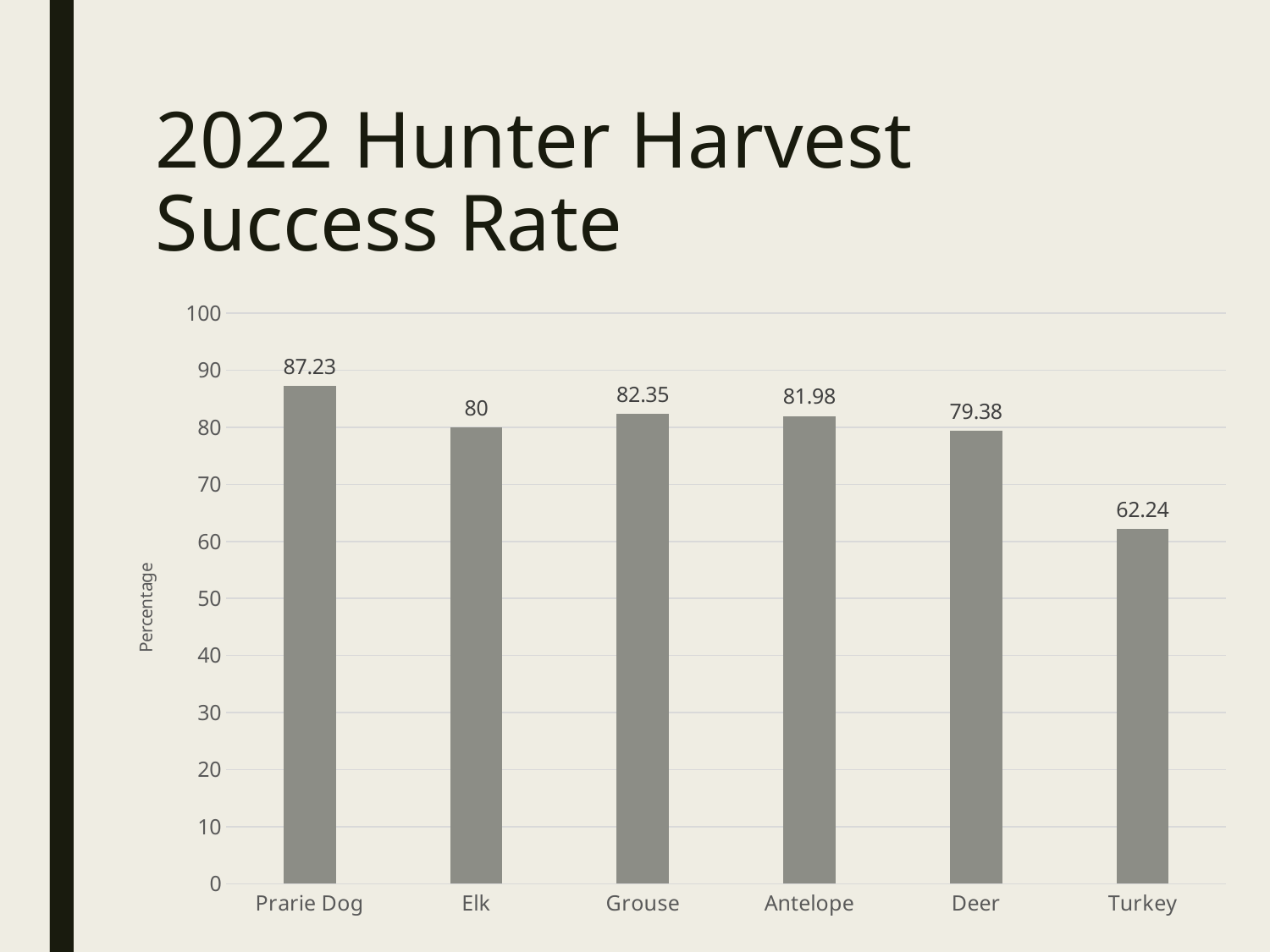
What is the value shown for Deer? 79.38 What is the difference between the values for Prarie Dog and Turkey? 24.99 What kind of chart is shown on the slide? bar chart Which category has the lowest success rate? Turkey Is the value for Antelope greater or less than 80? greater What is the difference between the values for Grouse and Elk? 2.35 What is the value shown for Turkey? 62.24 What is the label of the vertical axis? Percentage What is the hunter harvest success rate for Prarie Dog? 87.23 Which category has the highest success rate? Prarie Dog How many categories are shown on the x axis? 6 Which is larger, the value for Elk or the value for Deer? Elk